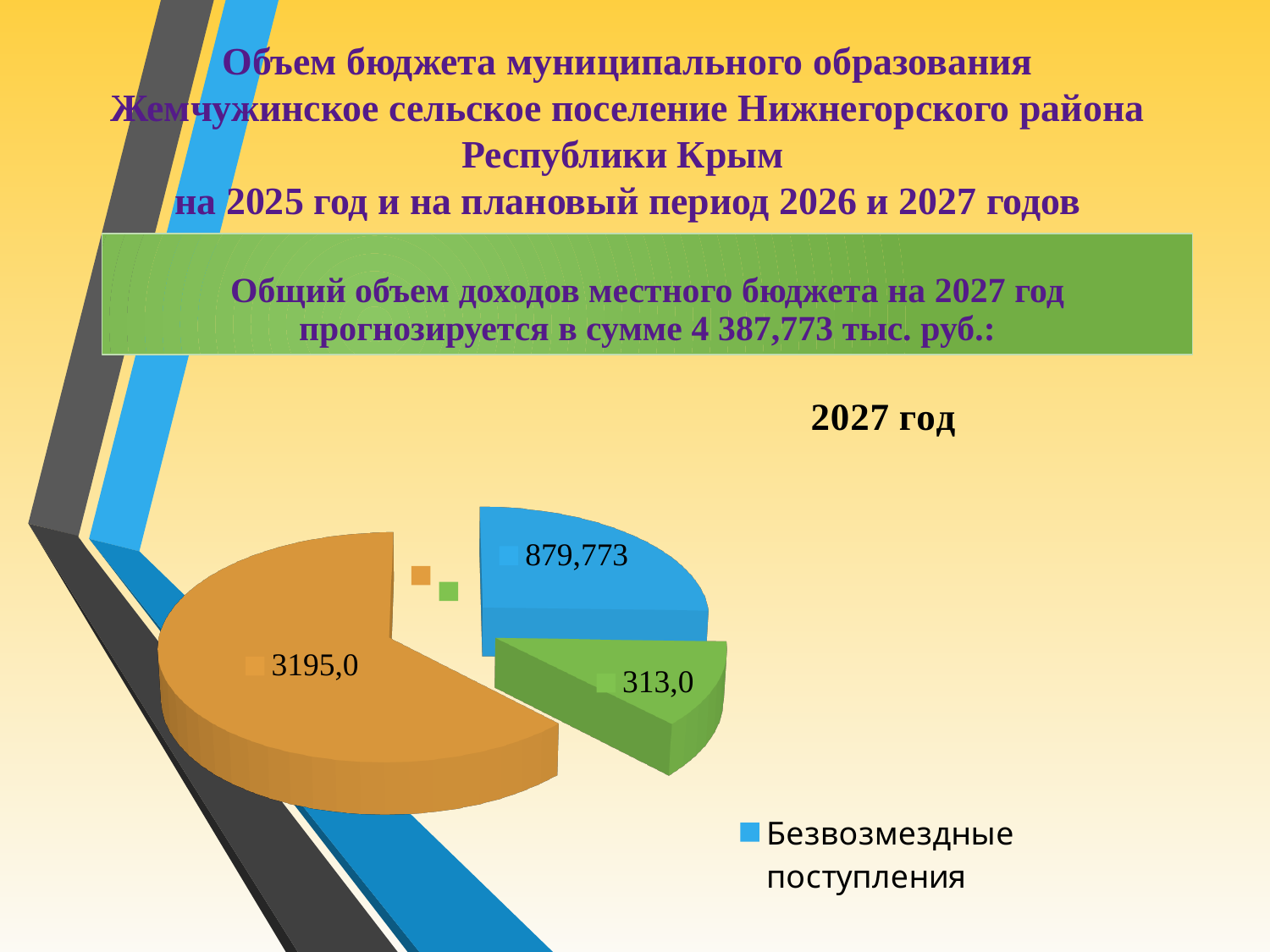
What colour represents Безвозмездные поступления in the pie chart? blue What is the difference between Безвозмездные поступления (879,773) and the green slice (313,0)? 566,773 What value is shown on the green slice of the pie chart? 313,0 Which slice of the pie chart has the smallest value? the green slice (313,0) What value is shown on the orange slice of the pie chart? 3195,0 What value is shown for Безвозмездные поступления in the pie chart? 879,773 Which slice of the pie chart has the largest value? the orange slice (3195,0) What type of chart is shown on the slide? pie chart Which is larger: the value for Безвозмездные поступления or the value of the green slice? Безвозмездные поступления (879,773) How many slices does the pie chart have? 3 What is the title of the chart? 2027 год What is the difference between the orange slice (3195,0) and Безвозмездные поступления (879,773)? 2315,227